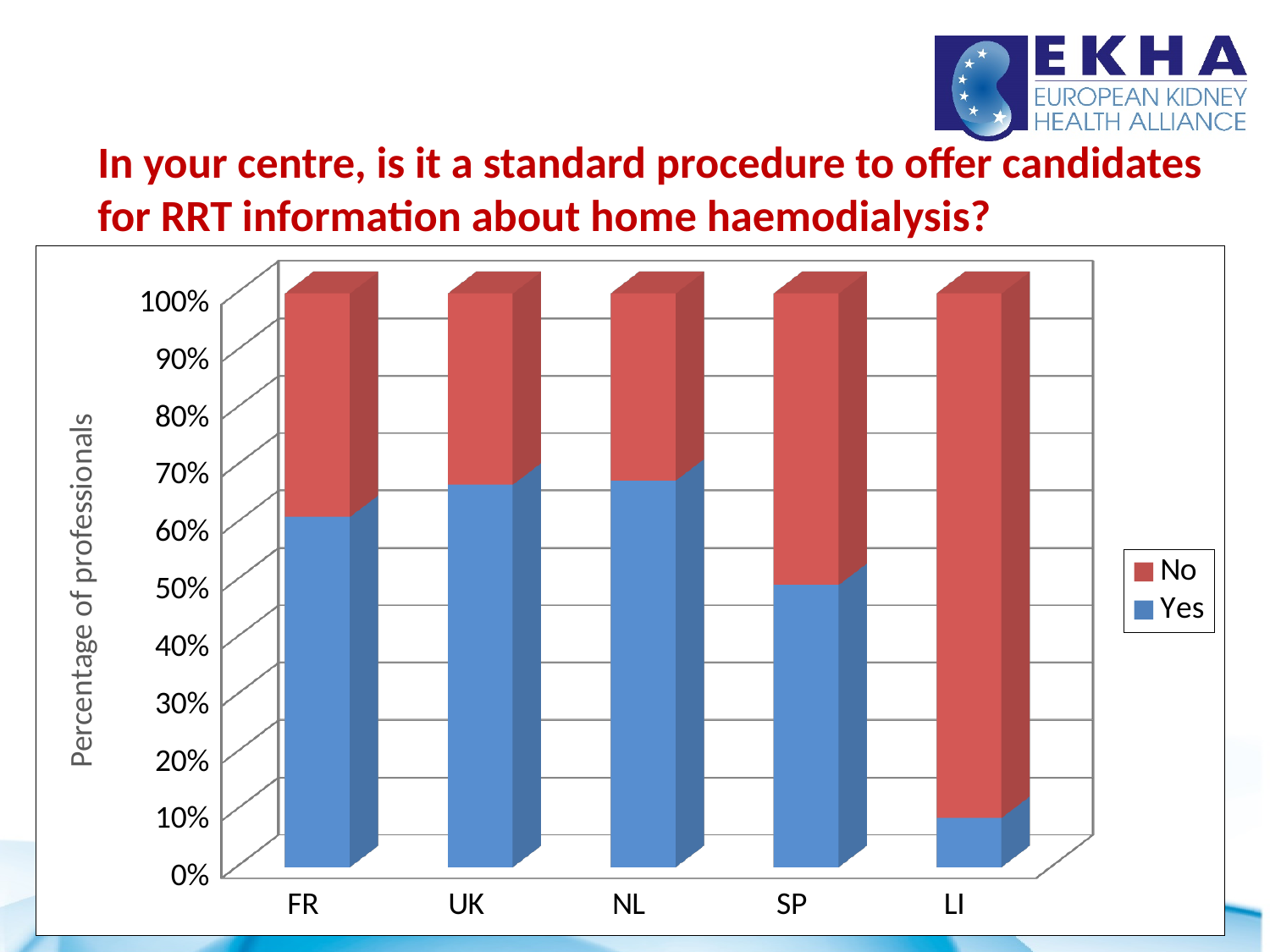
Which has a larger Yes share, FR or LI? FR Is the Yes share for FR greater or less than 50%? greater How many countries are shown on the x axis of the chart? 5 What is the title of the vertical axis of the chart? Percentage of professionals Is the Yes share for LI greater or less than 20%? less Which has a larger Yes share, UK or SP? UK What kind of chart is shown on the slide? Stacked bar chart Which country has the highest share of professionals answering No? LI Is the Yes share for UK greater or less than 60%? greater Which country has the lowest share of professionals answering Yes? LI How many series does the chart legend list? 2